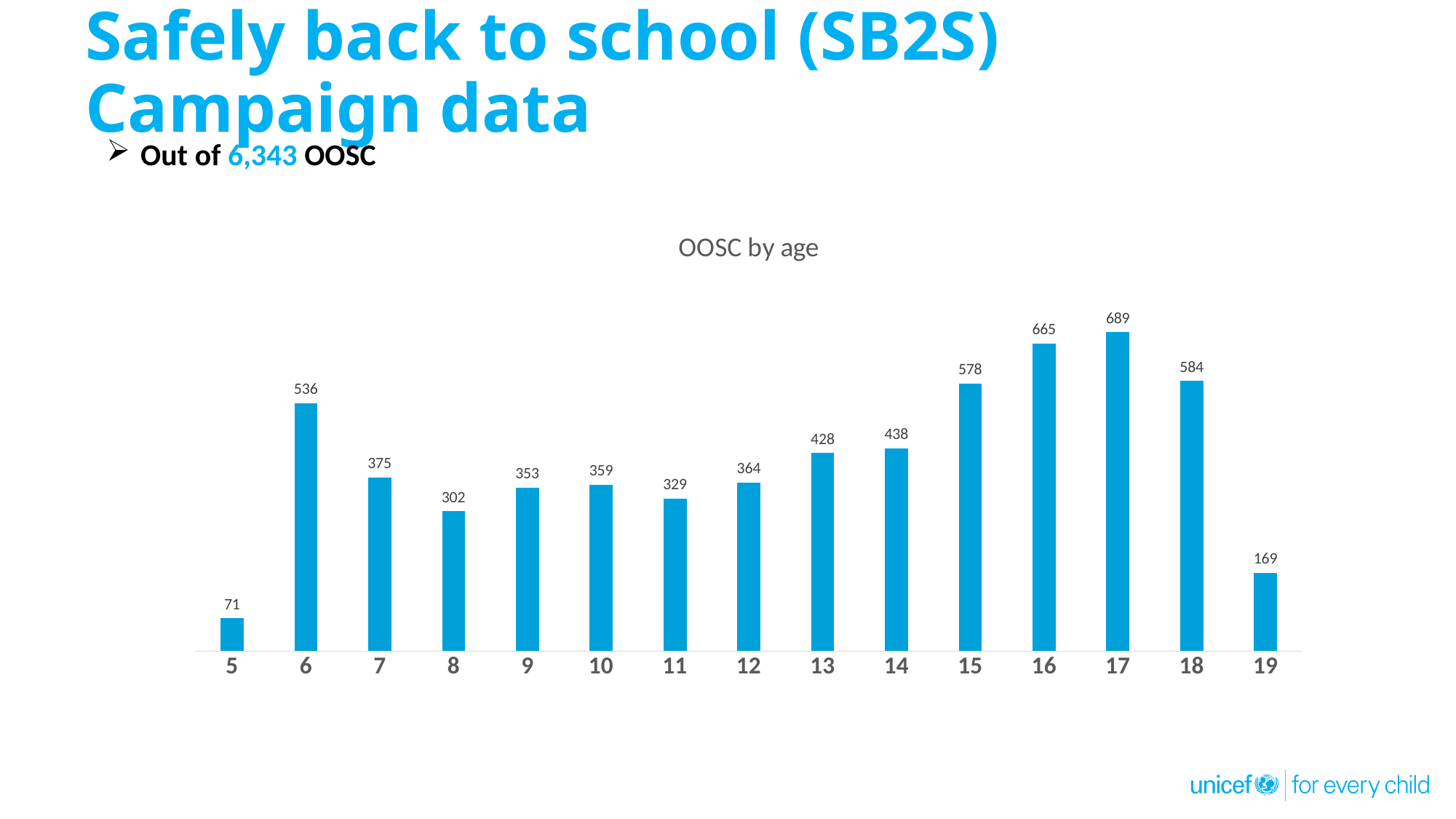
What is the value for age 5 in the OOSC by age chart? 71 Which is larger, the value for age 13 or the value for age 14? 14 What kind of chart is shown on the slide? Bar chart Which is larger, the value for age 18 or the value for age 19? 18 Which age has the lowest number of OOSC? 5 What is the value for age 12 in the OOSC by age chart? 364 How many age categories are shown in the chart? 15 What is the difference between the values for age 16 and age 15? 87 What is the title of the chart? OOSC by age Which age has the highest number of OOSC? 17 What is the value for age 17 in the OOSC by age chart? 689 What is the difference between the values for age 6 and age 7? 161